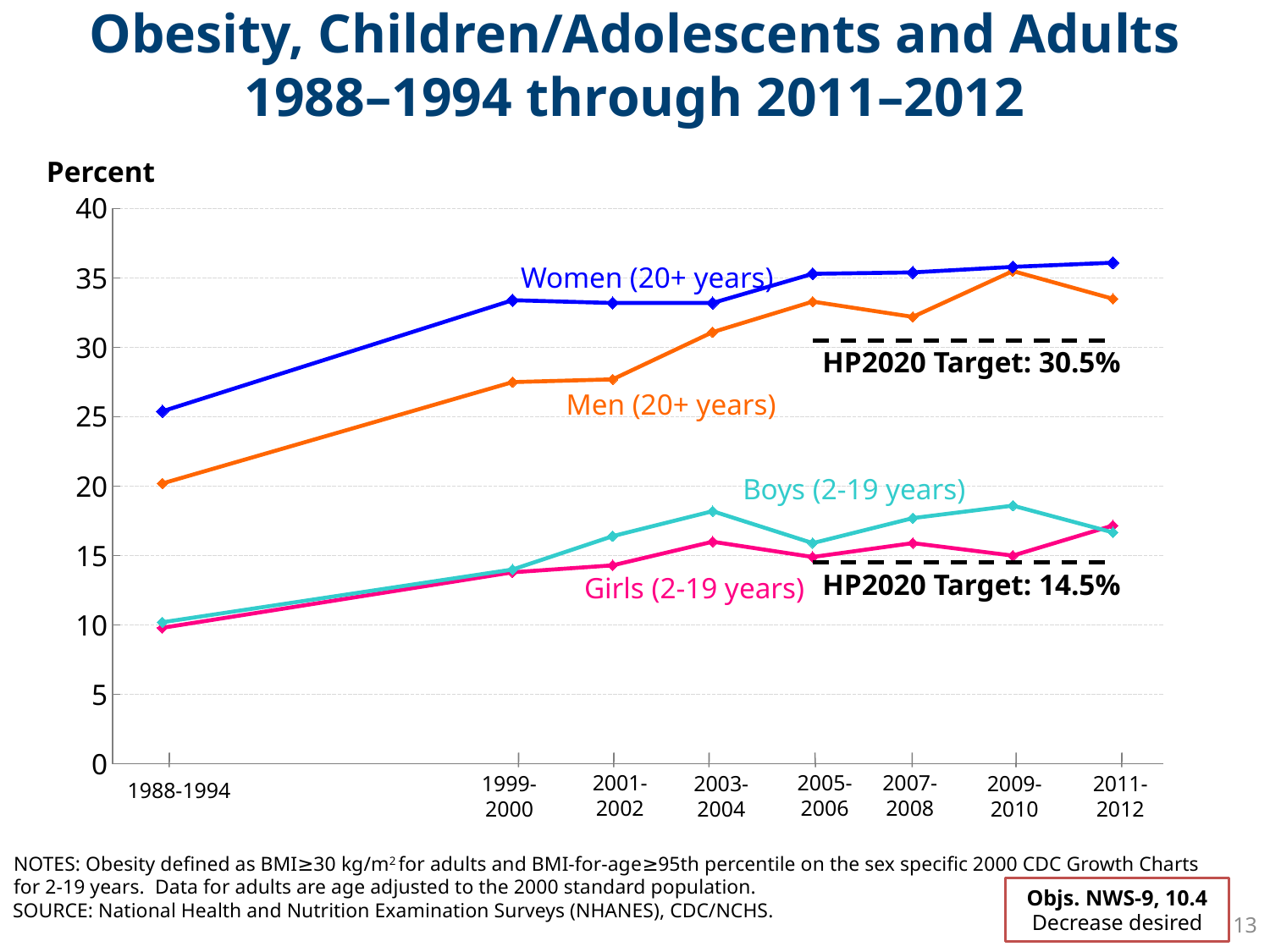
Which series has the lowest value in 2009-2010? Girls (2-19 years) Is the value for Women (20+ years) in 1988-1994 greater or less than 30? less Is the value for Women (20+ years) in 2011-2012 greater or less than 35? greater What kind of chart is shown on the slide? line chart Which series has the highest value in 2011-2012? Women (20+ years) How many survey periods are shown along the x axis? 8 Is the value for Men (20+ years) in 1988-1994 greater or less than 25? less How many data series (lines) are plotted on the chart? 4 Does the Women (20+ years) line rise or fall from 1988-1994 to 2011-2012? rise What is the HP2020 Target shown for adults (20+ years)? 30.5% In 2009-2010, which is larger: the value for Boys (2-19 years) or Girls (2-19 years)? Boys (2-19 years)